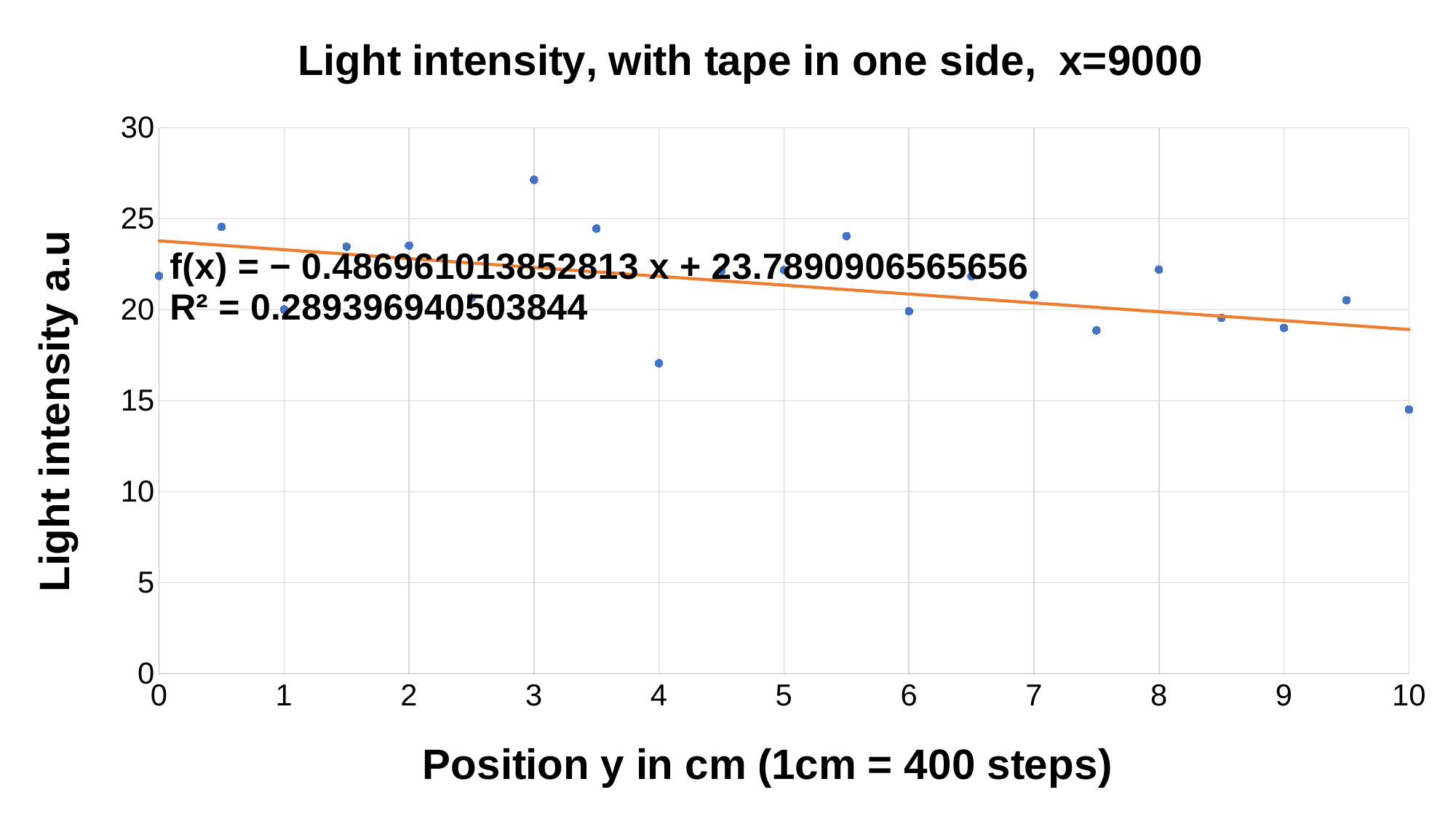
Which has the lower light intensity, position 7.5 or position 8? position 7.5 Is the light intensity at position 0.5 greater or less than 20? greater According to the fitted trend line, does light intensity rise or fall as position increases? fall Which has the higher light intensity, position 3 or position 4? position 3 At which x position is the highest light intensity point? 3 At which x position is the lowest light intensity point? 10 What kind of chart is shown on the slide? scatter chart Is the light intensity at position 4 greater or less than 20? less Is the light intensity at position 3 greater or less than 25? greater What is the label of the x axis? Position y in cm (1cm = 400 steps) What is the title of the chart? Light intensity, with tape in one side, x=9000